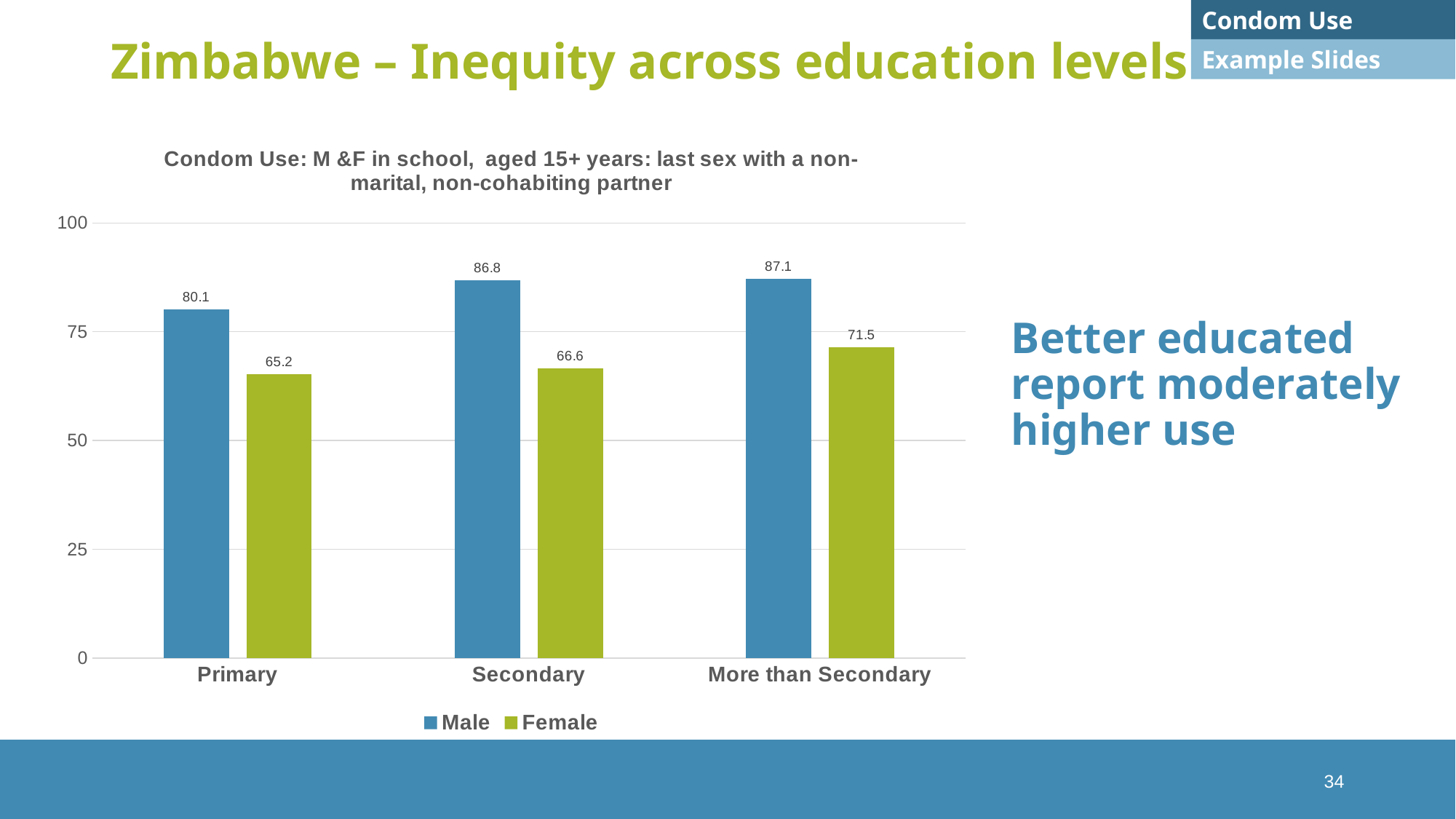
Which is larger, the Male value for Secondary or the Female value for More than Secondary? Male value for Secondary How many education level categories are shown on the x axis? 3 What kind of chart is shown on the slide? Bar chart What is the Female value for Secondary education? 66.6 How many series does the legend list? 2 What is the difference between the Male and Female values for Primary education? 14.9 What is the difference between the Female values for More than Secondary and Primary? 6.3 What is the Male value for Primary education? 80.1 Which education level has the lowest Female value? Primary What is the Female value for More than Secondary education? 71.5 Do the Female values rise or fall from Primary to More than Secondary? Rise Which education level has the highest Male value? More than Secondary